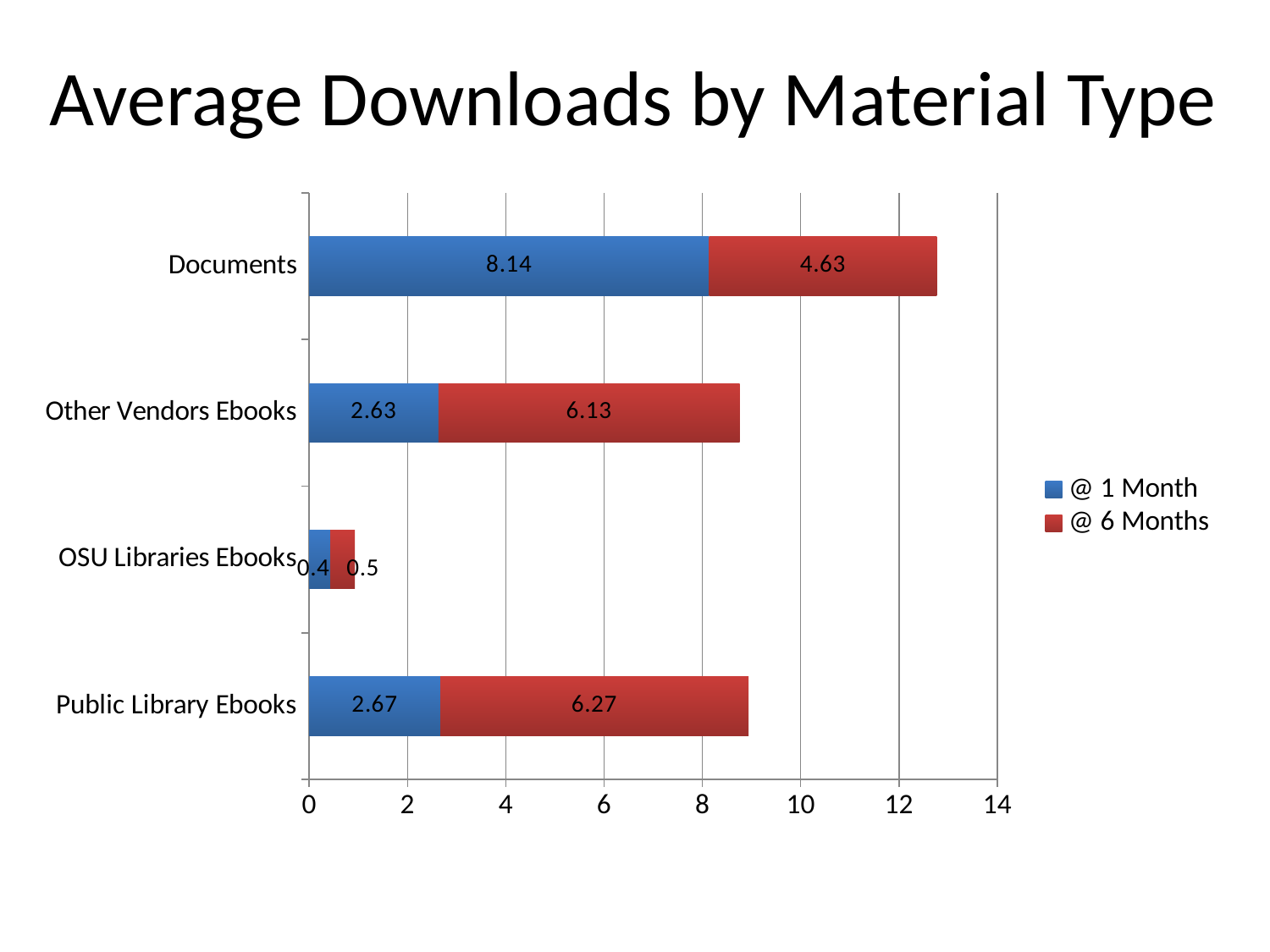
What is the total of the stacked bar for Public Library Ebooks? 8.94 How many material types are shown on the chart? 4 Which material type has the lowest @ 6 Months value? OSU Libraries Ebooks Which is larger for Other Vendors Ebooks: the @ 1 Month value or the @ 6 Months value? @ 6 Months What is the difference between the @ 1 Month and @ 6 Months values for Documents? 3.51 What is the @ 6 Months value for Other Vendors Ebooks? 6.13 What is the @ 1 Month value for Documents? 8.14 What is the @ 6 Months value for OSU Libraries Ebooks? 0.5 What is the @ 1 Month value for Public Library Ebooks? 2.67 What kind of chart is shown on the slide? Stacked bar chart Which material type has the highest @ 1 Month value? Documents How many series does the legend list? 2